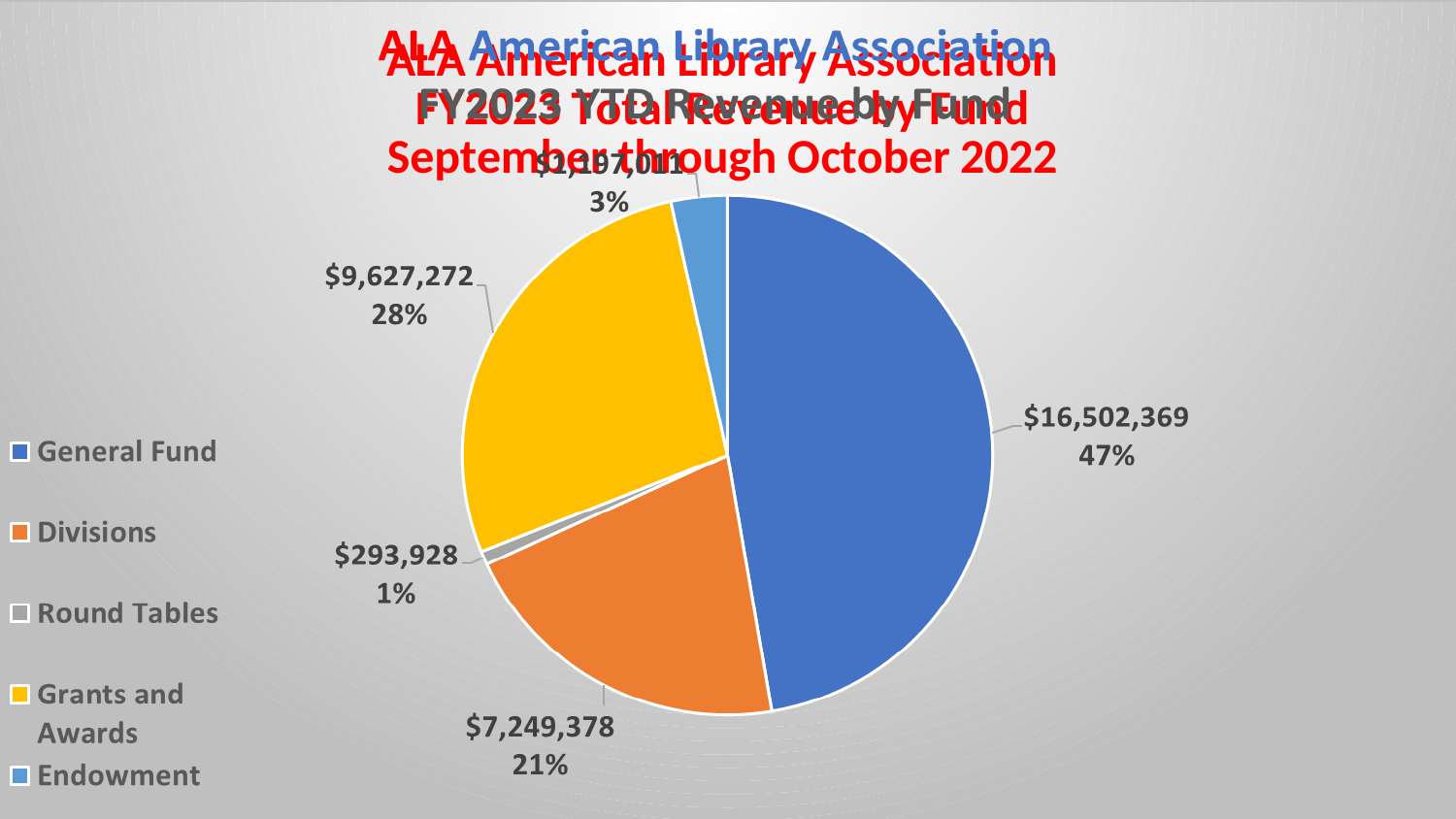
What share of total revenue does the General Fund represent? 47% Which fund has the smallest share of revenue? Round Tables What is the revenue value for Divisions? $7,249,378 Which is larger, the revenue for Grants and Awards or the revenue for Divisions? Grants and Awards What kind of chart is shown on the slide? pie chart What is the difference between the General Fund revenue and the Divisions revenue? $9,252,991 What is the revenue value for Grants and Awards? $9,627,272 What is the revenue value for Round Tables? $293,928 What share of total revenue does the Endowment represent? 3% How many funds are listed in the legend? 5 What is the revenue value for the General Fund? $16,502,369 Which fund has the largest share of revenue? General Fund